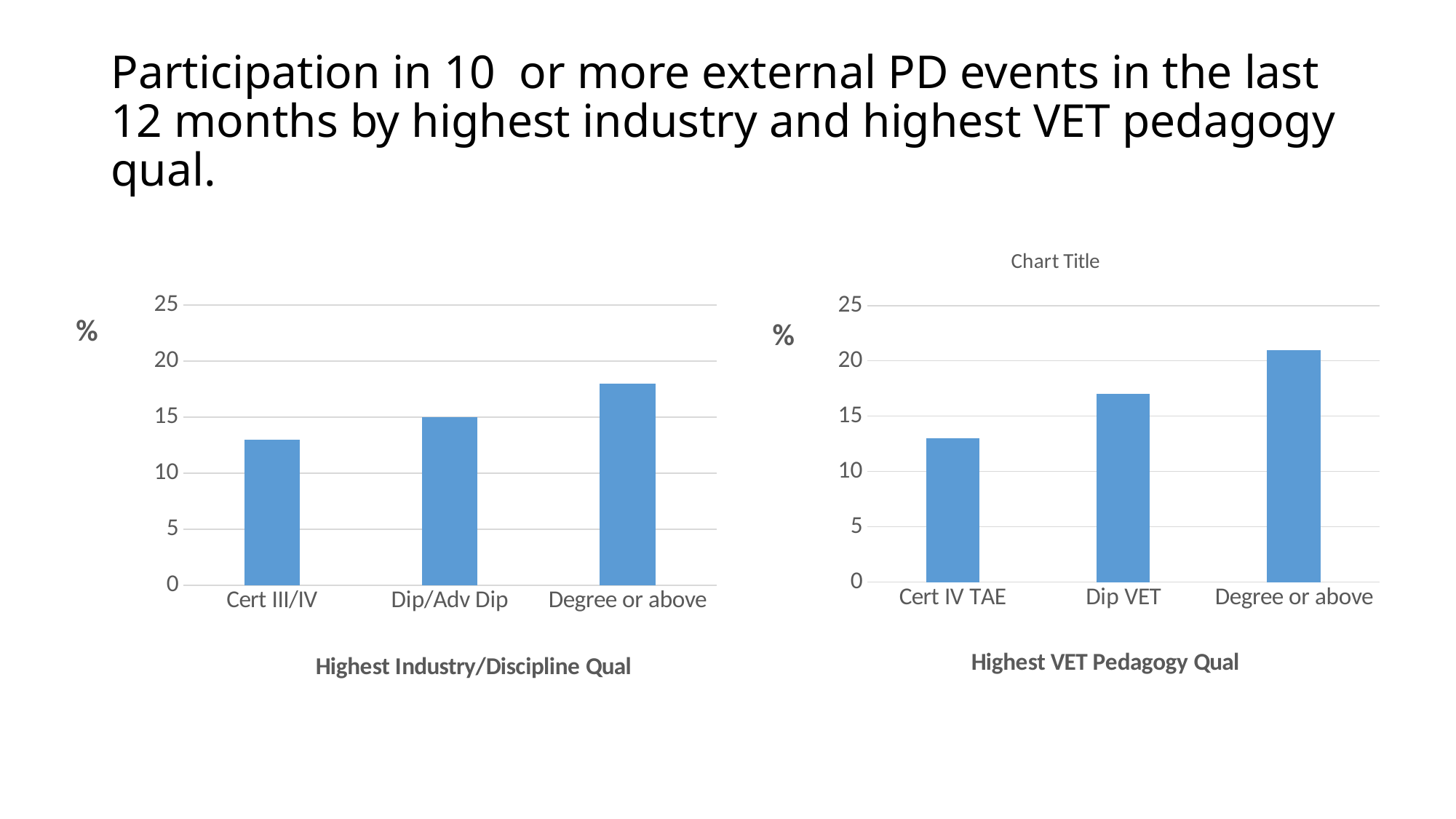
On the left chart (Highest Industry/Discipline Qual), is the value for Degree or above greater or less than 20? less On the right chart (Highest VET Pedagogy Qual), which category has the lowest value? Cert IV TAE How many categories are shown on the right chart (Highest VET Pedagogy Qual)? 3 On the left chart (Highest Industry/Discipline Qual), which category has the lowest value? Cert III/IV What kind of chart is the left chart (Highest Industry/Discipline Qual)? bar chart On the left chart (Highest Industry/Discipline Qual), which category has the highest value? Degree or above What is the x-axis title of the right chart? Highest VET Pedagogy Qual On the left chart (Highest Industry/Discipline Qual), do the values rise or fall from Cert III/IV to Degree or above? rise On the right chart (Highest VET Pedagogy Qual), which category has the highest value? Degree or above On the right chart (Highest VET Pedagogy Qual), is the value for Cert IV TAE greater or less than 15? less On the right chart (Highest VET Pedagogy Qual), is the value for Degree or above greater or less than 20? greater On the right chart (Highest VET Pedagogy Qual), which is larger: Dip VET or Cert IV TAE? Dip VET